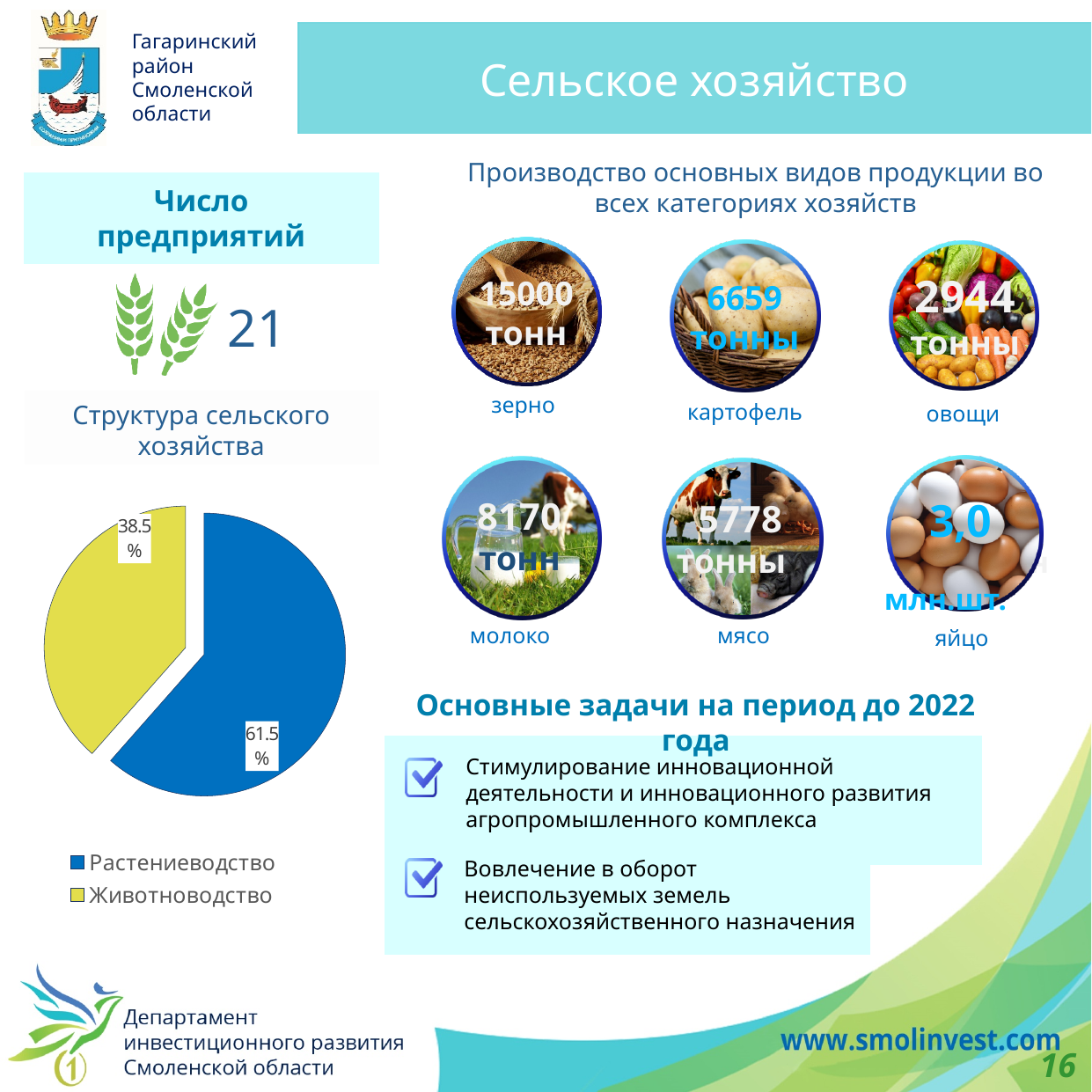
What kind of chart is shown under "Структура сельского хозяйства"? pie chart How many slices does the pie chart have? 2 Which slice of the pie chart is the smallest? Животноводство How many entries does the pie chart legend list? 2 Which is larger in the pie chart, Растениеводство or Животноводство? Растениеводство By how many percentage points does Растениеводство exceed Животноводство in the pie chart? 23 Which slice of the pie chart is the largest? Растениеводство What colour is the Животноводство slice in the pie chart? yellow What share of the pie chart does Растениеводство have? 61.5% Is the share of Животноводство in the pie chart greater or less than 50%? less What share of the pie chart does Животноводство have? 38.5% What is the title of the pie chart? Структура сельского хозяйства